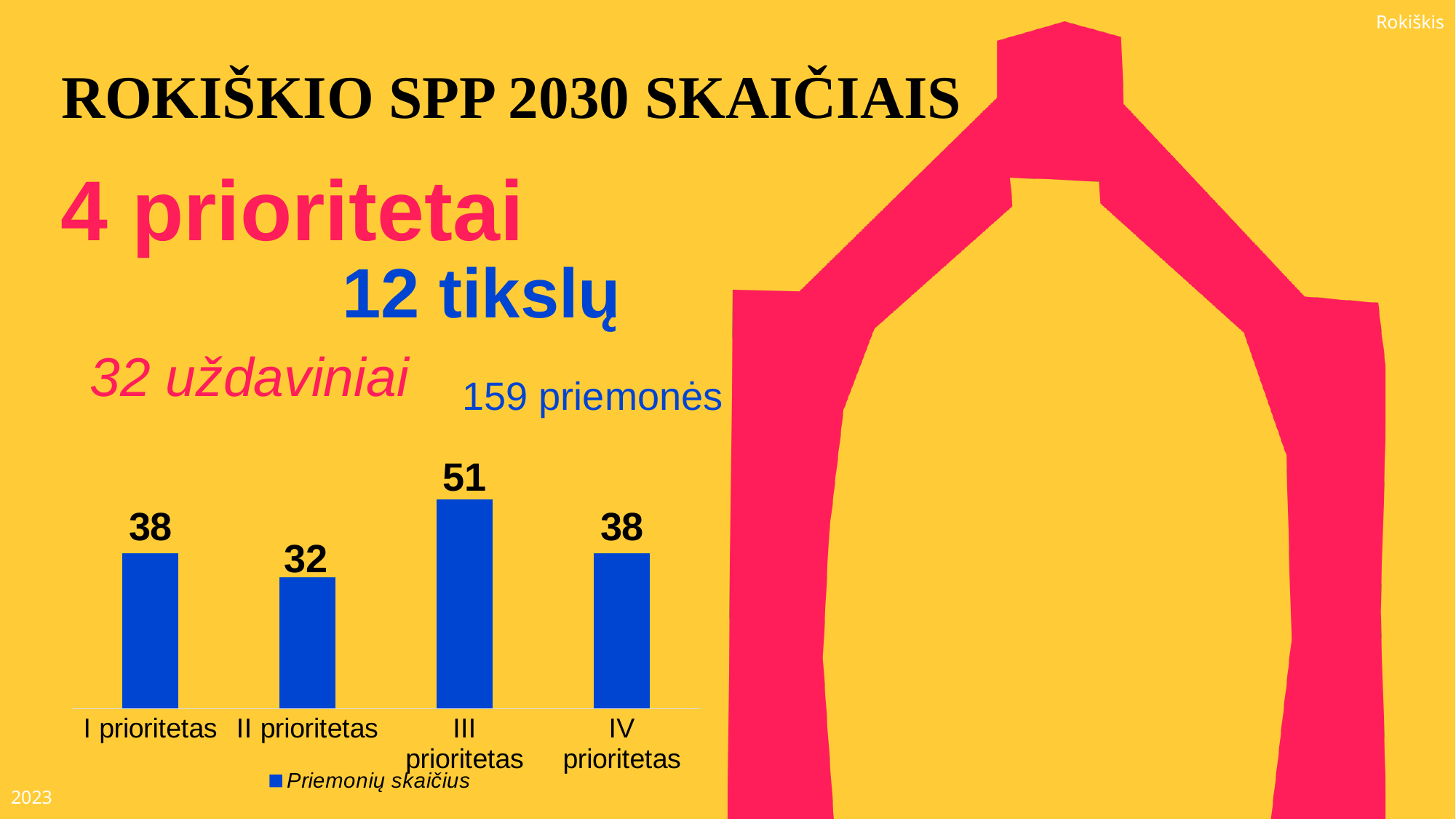
How many categories are shown in the chart? 4 What series name does the chart legend show? Priemonių skaičius What is the value for II prioritetas? 32 What is the difference between the values for III prioritetas and II prioritetas? 19 What is the value for IV prioritetas? 38 What kind of chart is shown on the slide? bar chart Which is larger, the value for I prioritetas or the value for II prioritetas? I prioritetas Which category has the lowest value? II prioritetas What is the value for I prioritetas? 38 What is the value for III prioritetas? 51 Which category has the highest value? III prioritetas What is the difference between the values for III prioritetas and I prioritetas? 13